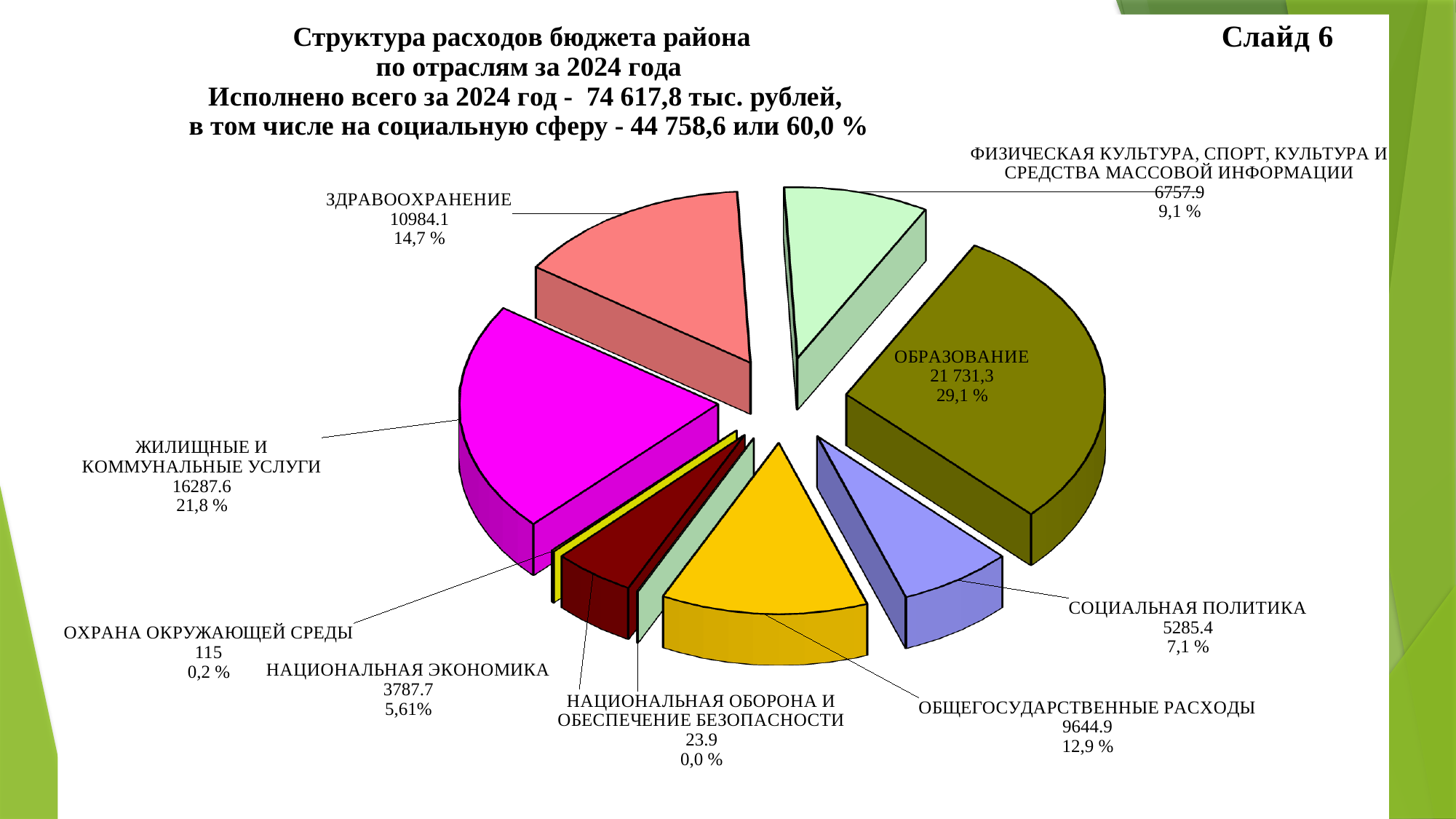
How many slices (categories) does the pie chart have? 9 What kind of chart is shown on the slide? pie chart Which category has the smallest value in the pie chart? НАЦИОНАЛЬНАЯ ОБОРОНА И ОБЕСПЕЧЕНИЕ БЕЗОПАСНОСТИ What share of the pie does ОБЩЕГОСУДАРСТВЕННЫЕ РАСХОДЫ represent? 12,9 % What is the value shown for ОБРАЗОВАНИЕ? 21 731,3 What total executed amount for 2024 is stated in the chart title? 74 617,8 тыс. рублей What is the value shown for ЗДРАВООХРАНЕНИЕ? 10984.1 What is the difference between the values for ЗДРАВООХРАНЕНИЕ and ОБЩЕГОСУДАРСТВЕННЫЕ РАСХОДЫ? 1339.2 What share of the pie does ЖИЛИЩНЫЕ И КОММУНАЛЬНЫЕ УСЛУГИ represent? 21,8 % Which is larger: the value for НАЦИОНАЛЬНАЯ ЭКОНОМИКА or the value for СОЦИАЛЬНАЯ ПОЛИТИКА? СОЦИАЛЬНАЯ ПОЛИТИКА What is the value shown for СОЦИАЛЬНАЯ ПОЛИТИКА? 5285.4 Which category has the largest slice of the pie? ОБРАЗОВАНИЕ